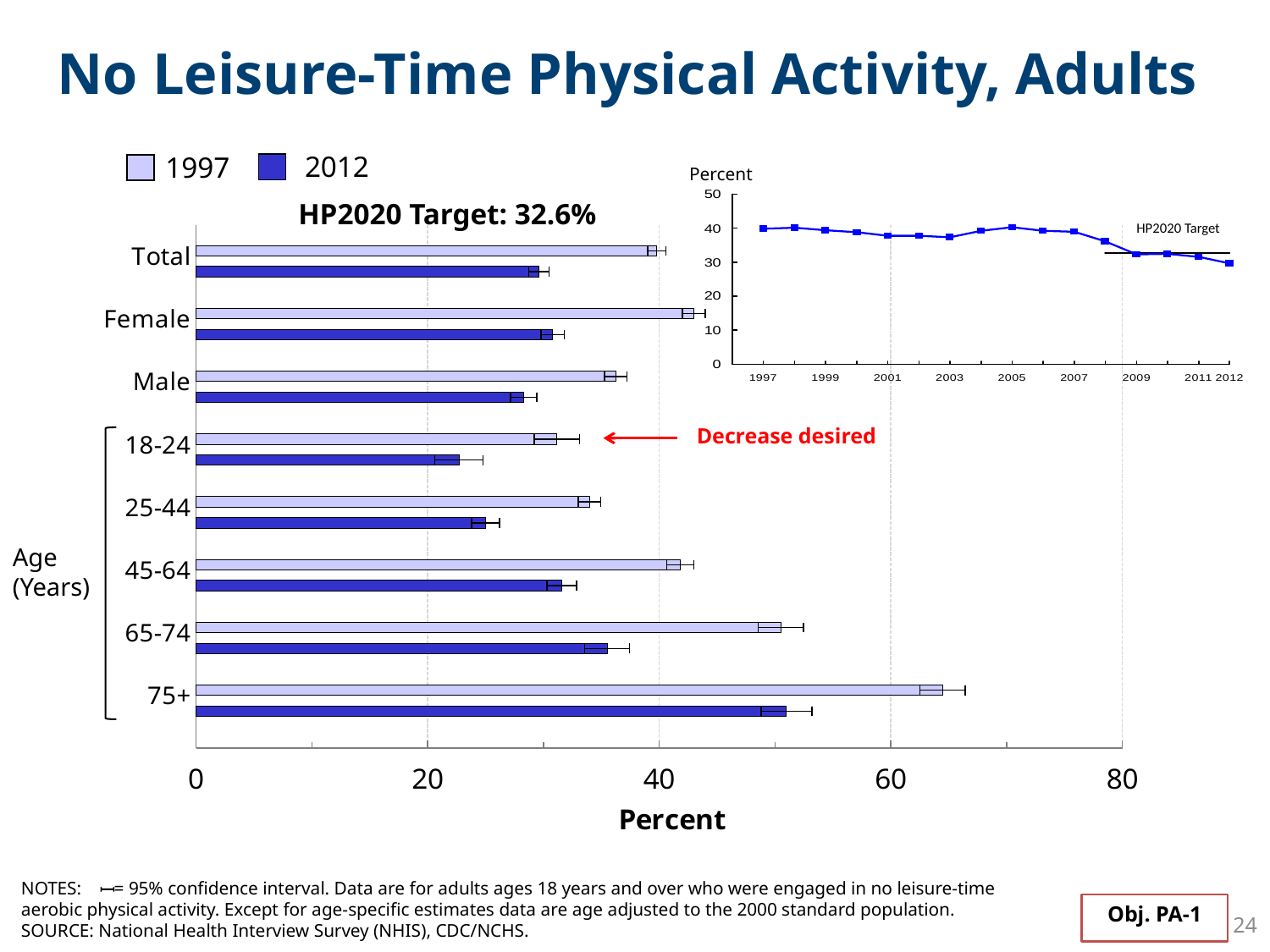
In the main bar chart, is the 2012 value for 18-24 greater or less than 20? greater In the main bar chart, which category has the highest 1997 value? 75+ In the main bar chart, how many categories are shown on the vertical axis? 8 In the main bar chart, which is larger for Female: the 1997 value or the 2012 value? 1997 What is the HP2020 Target shown on the slide? 32.6% What kind of chart is the main chart on the left of the slide? bar chart In the main bar chart, is the 1997 value for 75+ greater or less than 60? greater What kind of chart is the small inset chart in the top right of the slide? line chart In the main bar chart, which 2012 value is larger: 65-74 or 45-64? 65-74 In the main bar chart, which category has the lowest 2012 value? 18-24 In the main bar chart, is the 2012 value for 75+ greater or less than 40? greater In the main bar chart, how many series does the legend list? 2